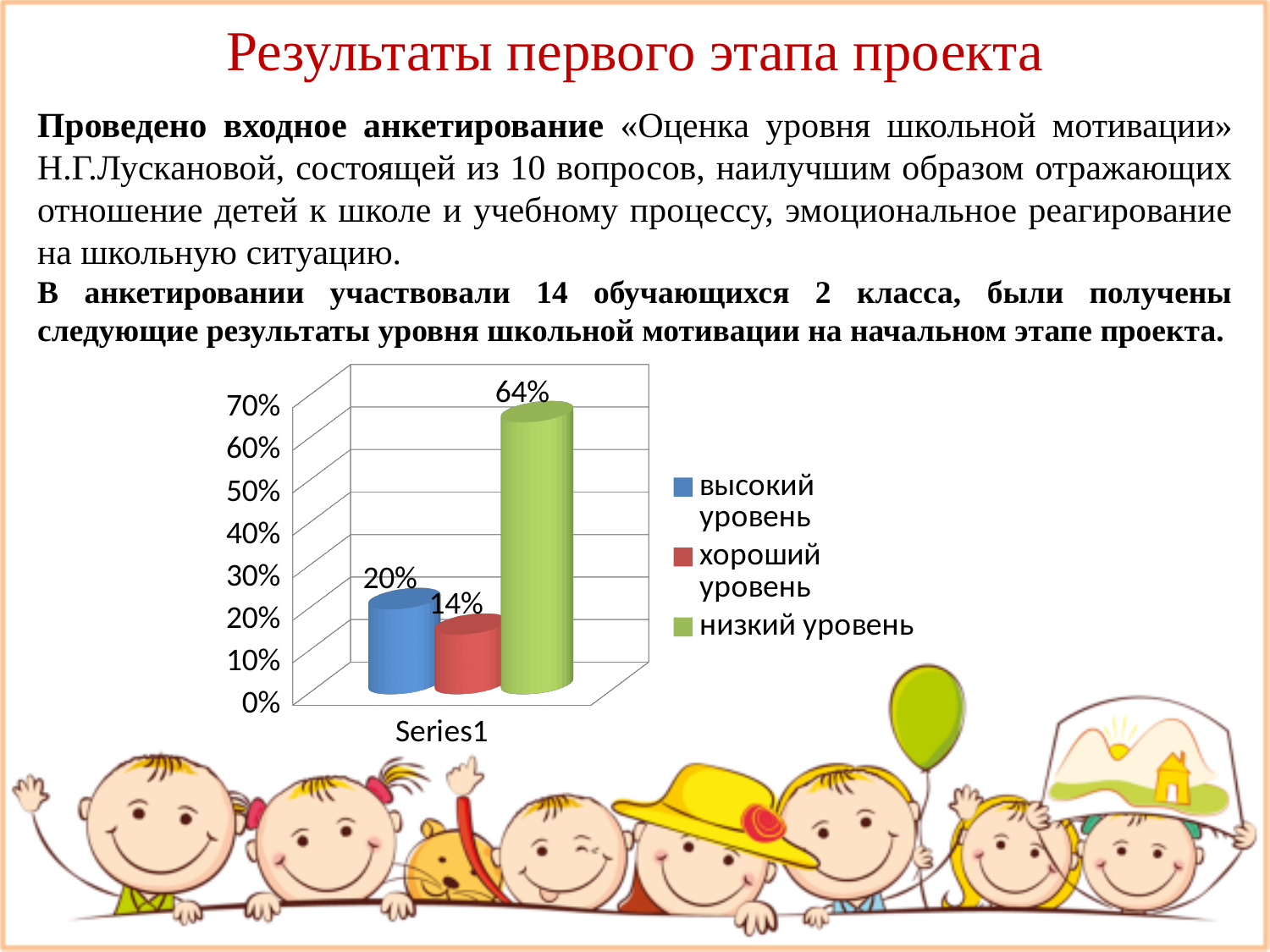
How many series does the legend list? 3 What is the value for низкий уровень? 64% What is the difference between the values for высокий уровень and хороший уровень? 6% Which level has the lowest value? хороший уровень What colour is the bar for низкий уровень? green Is the value for низкий уровень greater or less than 50%? greater What is the value for высокий уровень? 20% What is the value for хороший уровень? 14% Which is larger, the value for высокий уровень or the value for хороший уровень? высокий уровень Which level has the highest value? низкий уровень What is the difference between the values for низкий уровень and высокий уровень? 44% What kind of chart is shown on the slide? bar chart